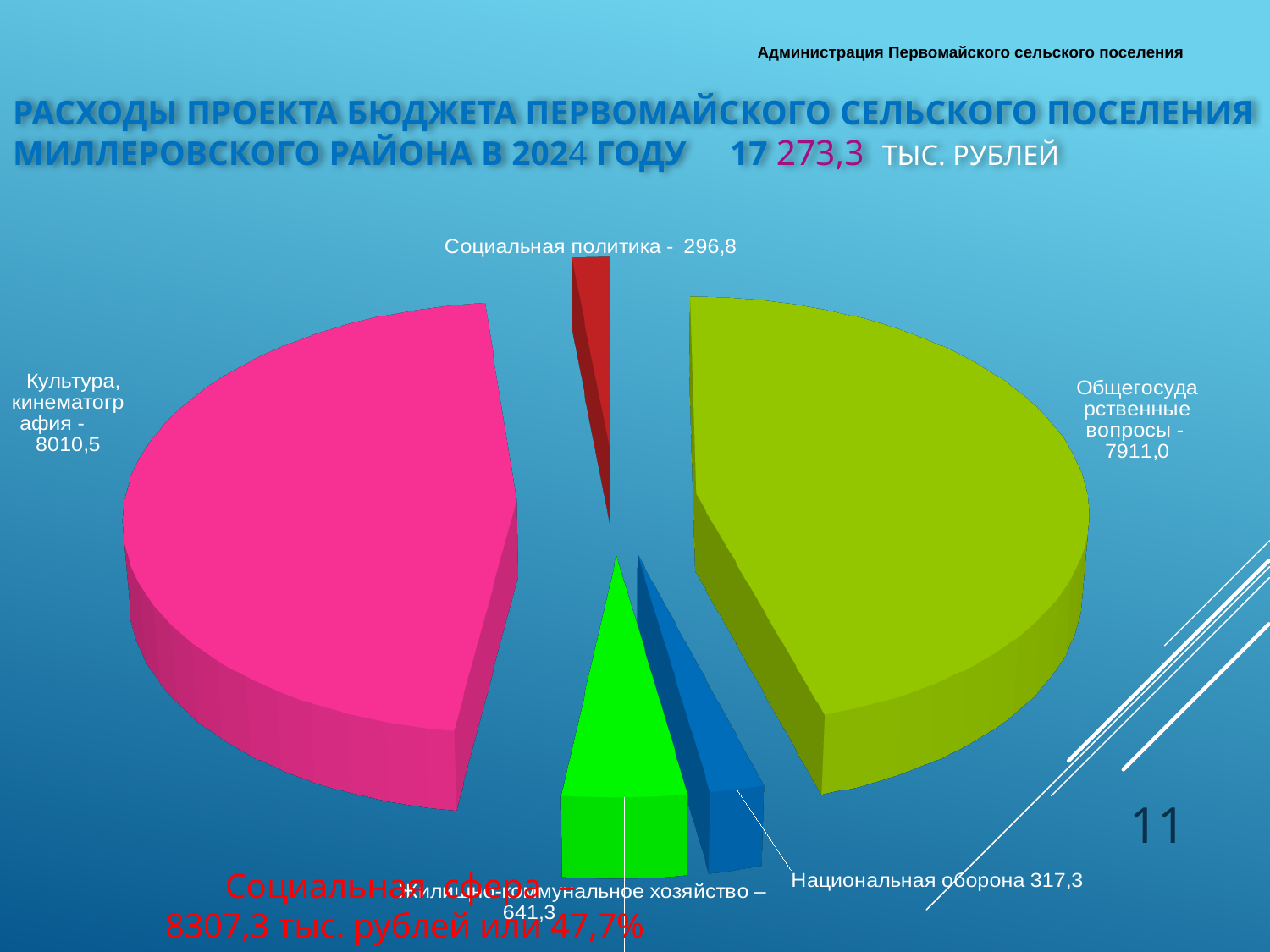
What is the value shown for Культура, кинематография? 8010,5 What is the value shown for Жилищно-коммунальное хозяйство? 641,3 How many slices does the pie chart have? 5 What is the value shown for Национальная оборона? 317,3 What is the value shown for Социальная политика? 296,8 Which is larger: the value for Жилищно-коммунальное хозяйство or the value for Национальная оборона? Жилищно-коммунальное хозяйство Which category has the smallest value in the pie chart? Социальная политика Which category has the largest value in the pie chart? Культура, кинематография What is the difference between the values for Культура, кинематография and Общегосударственные вопросы? 99,5 What is the value shown for Общегосударственные вопросы? 7911,0 What type of chart is shown on the slide? pie chart What total amount of expenditures in тыс. рублей is stated in the slide title? 17 273,3